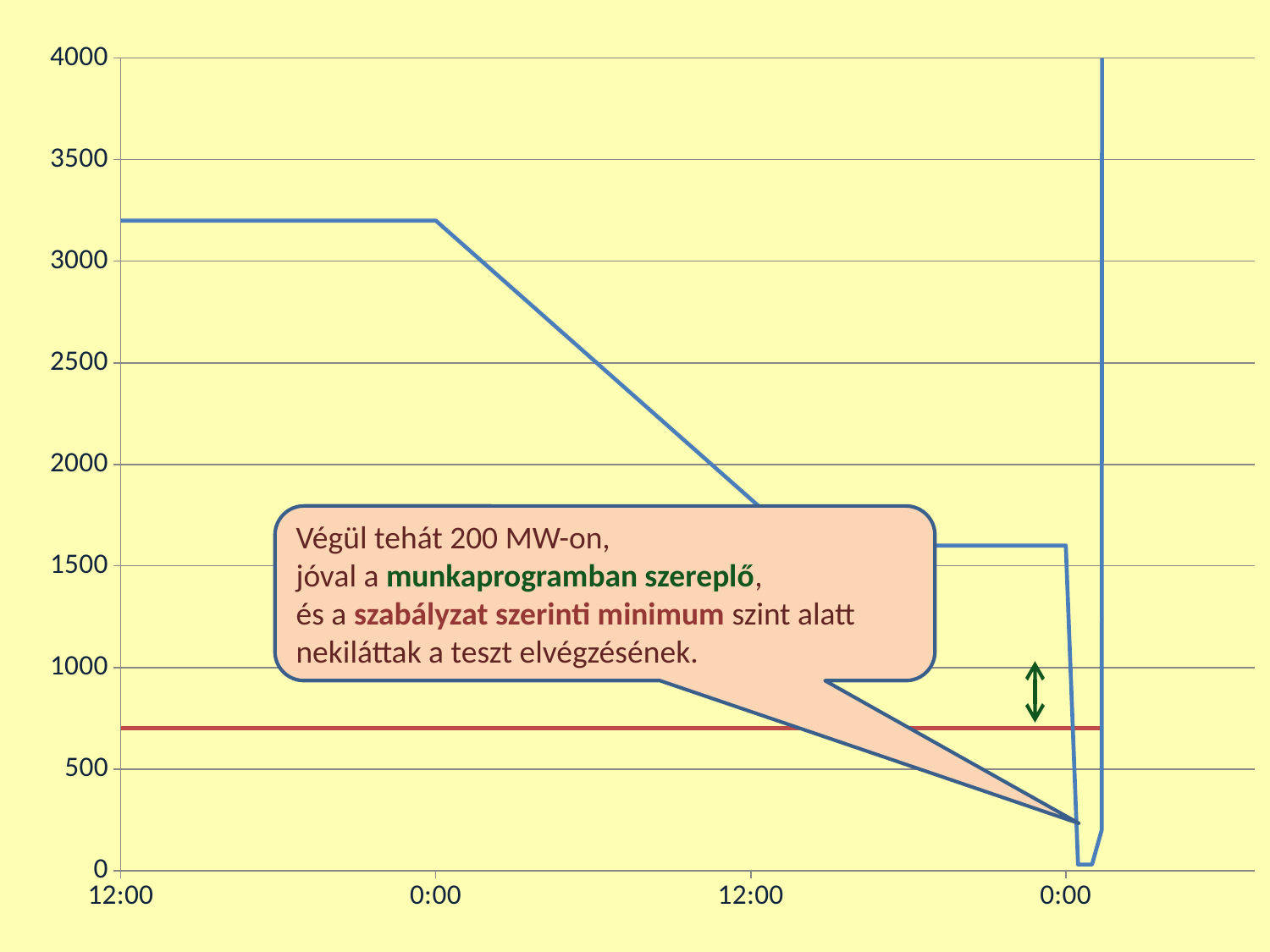
Is the level of the red horizontal line greater or less than 500? greater Is the level of the red horizontal line greater or less than 1000? less What is the highest value shown on the y axis? 4000 What is the first time label on the x axis? 12:00 Is the value of the blue line at the start of the chart (12:00) greater or less than 3500? less Which is higher at the final 0:00 on the x axis: the blue line's lowest point or the red horizontal line? the red horizontal line According to the callout text, at what power level was the test started? 200 MW How many time labels are shown on the x axis? 4 Does the blue line rise or fall between the first 0:00 and the second 12:00 on the x axis? fall What kind of chart is shown on the slide? line chart